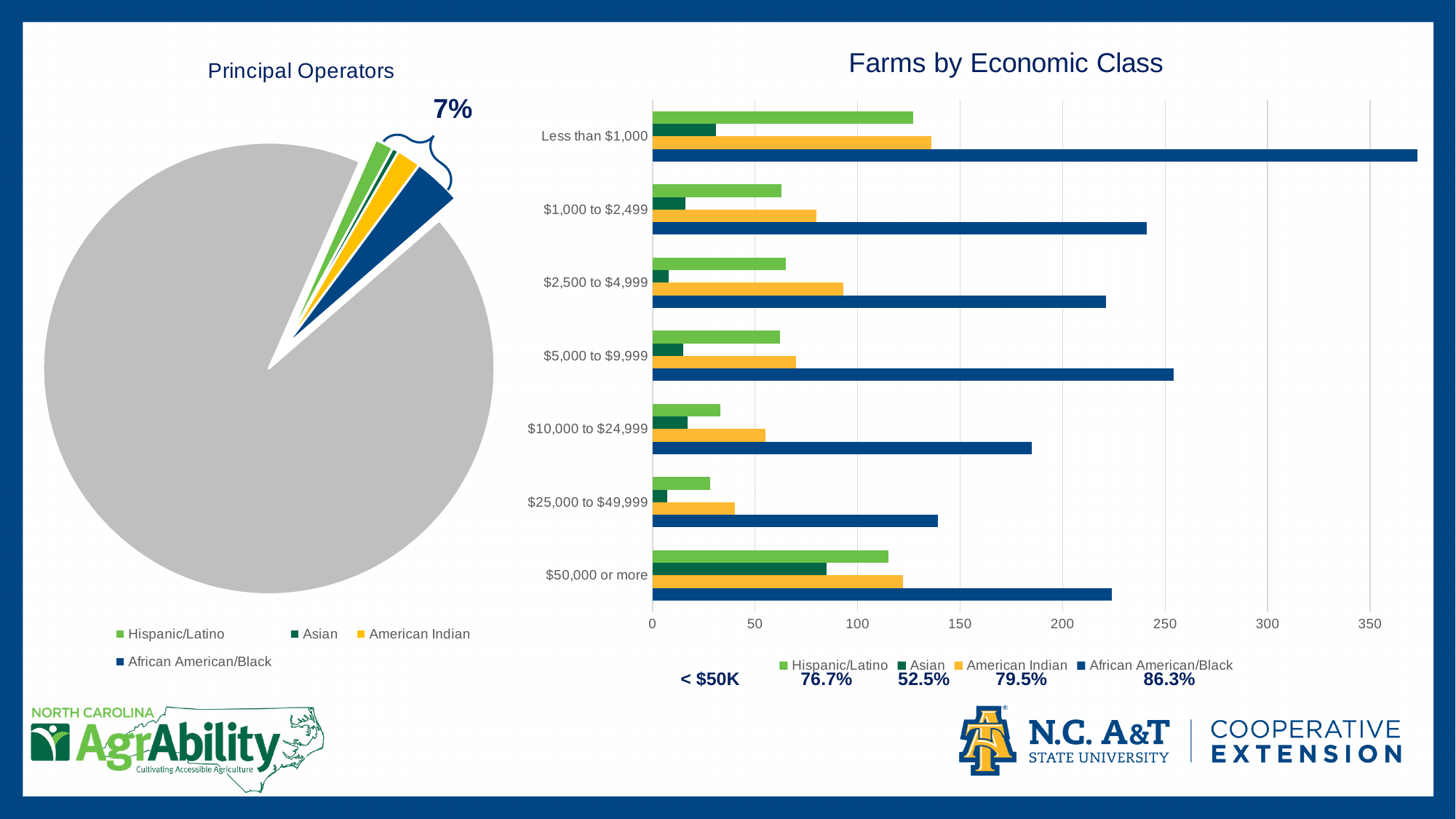
What kind of chart is "Farms by Economic Class"? bar chart In "Farms by Economic Class", which economic class has the highest value for African American/Black? Less than $1,000 In "Farms by Economic Class", is the African American/Black value for Less than $1,000 greater or less than 350? greater In "Farms by Economic Class", for Less than $1,000, which is larger: Hispanic/Latino or Asian? Hispanic/Latino In "Farms by Economic Class", how many economic class categories are shown on the y axis? 7 In "Farms by Economic Class", how many series does the legend list? 4 In "Farms by Economic Class", which economic class has the highest value for Asian? $50,000 or more What kind of chart is "Principal Operators"? pie chart In "Farms by Economic Class", is the American Indian value for $1,000 to $2,499 greater or less than 100? less In "Farms by Economic Class", which economic class has the lowest value for African American/Black? $25,000 to $49,999 In "Principal Operators", what percentage label is shown next to the exploded slices? 7% In "Farms by Economic Class", is the Asian value for $50,000 or more greater or less than 50? greater